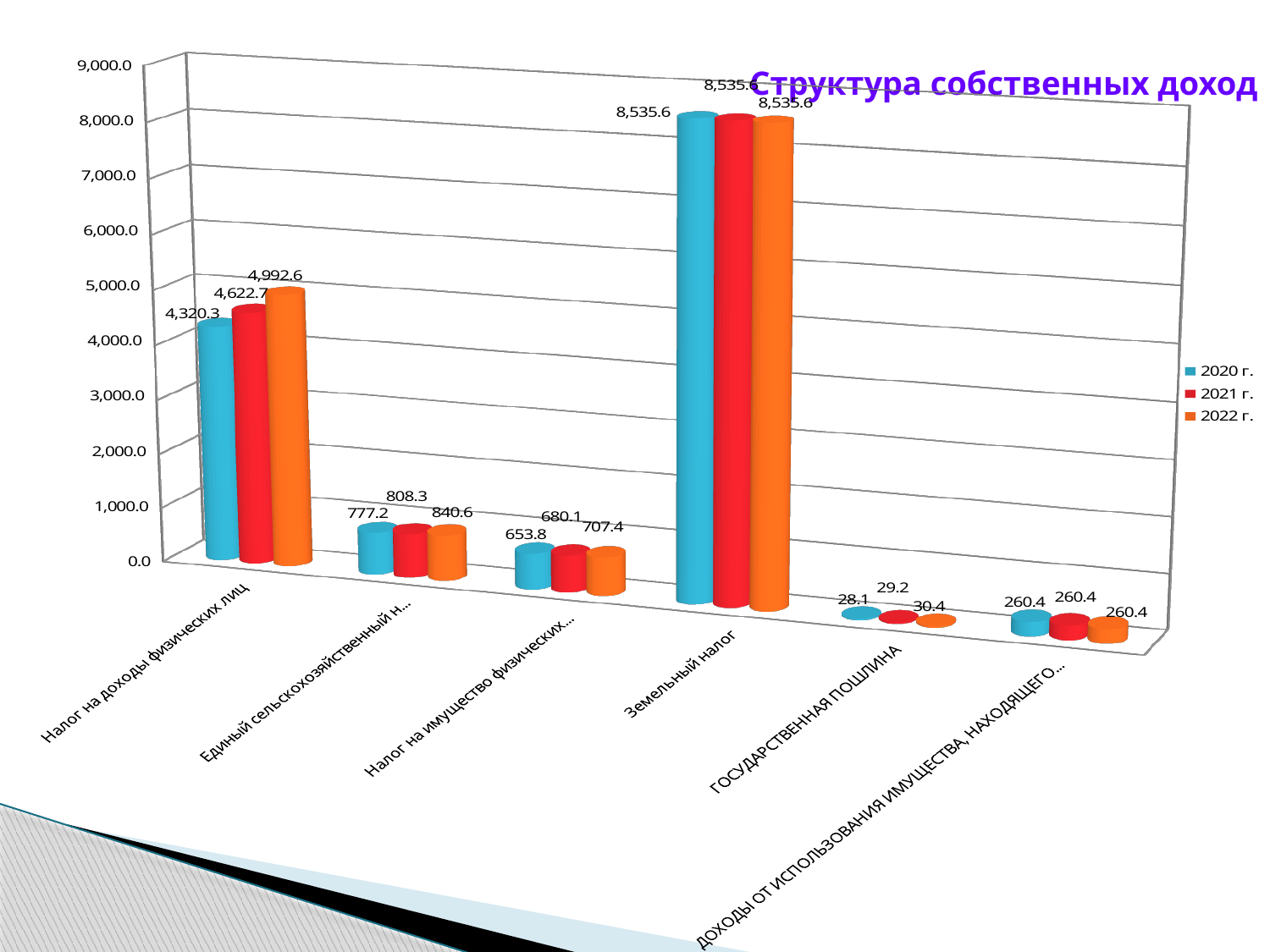
Which category has the lowest value in 2021 г.? ГОСУДАРСТВЕННАЯ ПОШЛИНА What is the difference between the 2022 г. and 2020 г. values for Налог на доходы физических лиц? 672.3 What is the value for Земельный налог in 2021 г.? 8,535.6 How many series does the legend list? 3 What is the value for ГОСУДАРСТВЕННАЯ ПОШЛИНА in 2022 г.? 30.4 Do the values for Налог на имущество физических лиц rise or fall from 2020 г. to 2022 г.? Rise How many categories are shown on the x axis? 6 Which category has the highest value in 2020 г.? Земельный налог What is the value for Налог на доходы физических лиц in 2020 г.? 4,320.3 Which is larger for 2021 г.: Единый сельскохозяйственный налог or Налог на имущество физических лиц? Единый сельскохозяйственный налог What kind of chart is shown on the slide? Bar chart What is the value for Налог на доходы физических лиц in 2022 г.? 4,992.6